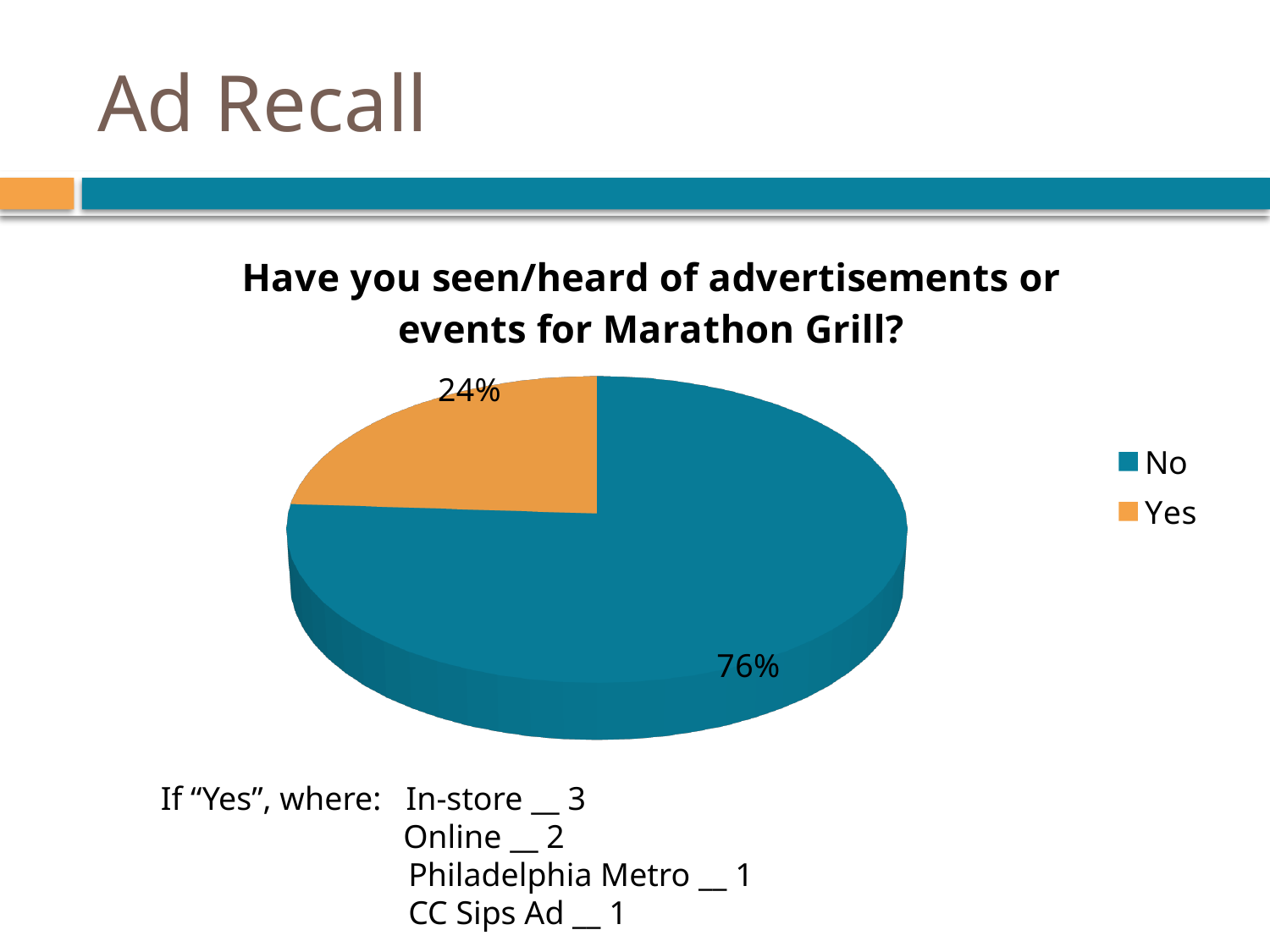
What is the title of the chart? Have you seen/heard of advertisements or events for Marathon Grill? How many entries does the legend list? 2 Which response has the smallest share of the pie? Yes What type of chart is shown on the slide? Pie chart What colour is the "Yes" slice? Orange What is the difference in percentage points between the "No" and "Yes" slices? 52 Which slice is larger, "No" or "Yes"? No What percentage of respondents answered "Yes"? 24% What share of the pie does the "Yes" slice represent? 24% Which response has the largest share of the pie? No What percentage of respondents answered "No"? 76% How many slices does the pie chart have? 2